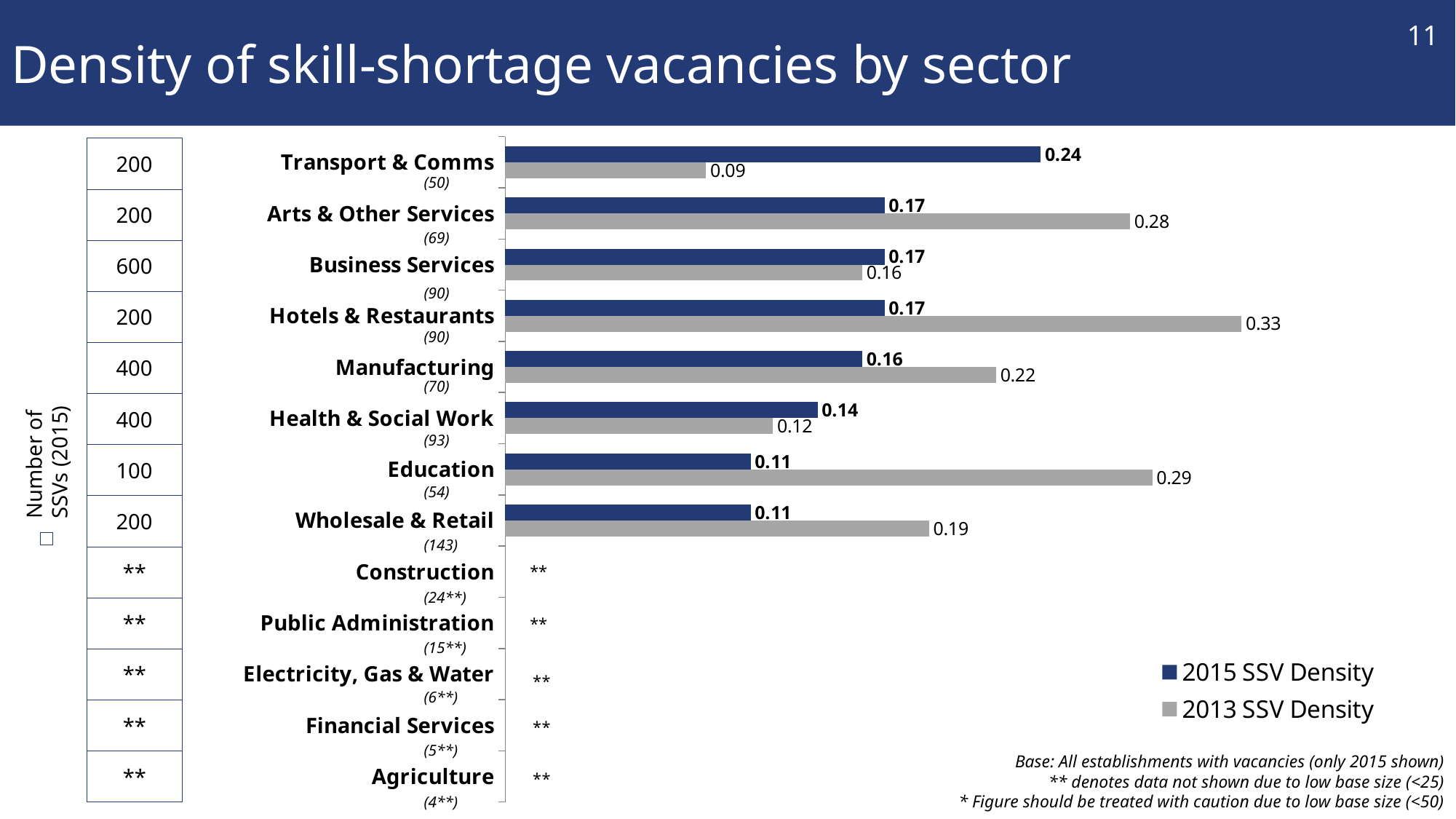
What is the 2013 SSV Density for Hotels & Restaurants? 0.33 What is the difference between the 2013 and 2015 SSV Density for Education? 0.18 Which sector has the highest 2015 SSV Density? Transport & Comms For Manufacturing, which is larger: the 2015 SSV Density or the 2013 SSV Density? 2013 SSV Density How many series does the legend list? 2 How many sectors show ** instead of bars because of low base size? 5 What is the 2013 SSV Density for Education? 0.29 What is the 2015 SSV Density for Health & Social Work? 0.14 Which sector has the lowest 2013 SSV Density among those with values shown? Transport & Comms What is the difference between the 2015 and 2013 SSV Density for Transport & Comms? 0.15 What is the 2015 SSV Density for Transport & Comms? 0.24 What kind of chart is shown on the slide? Bar chart